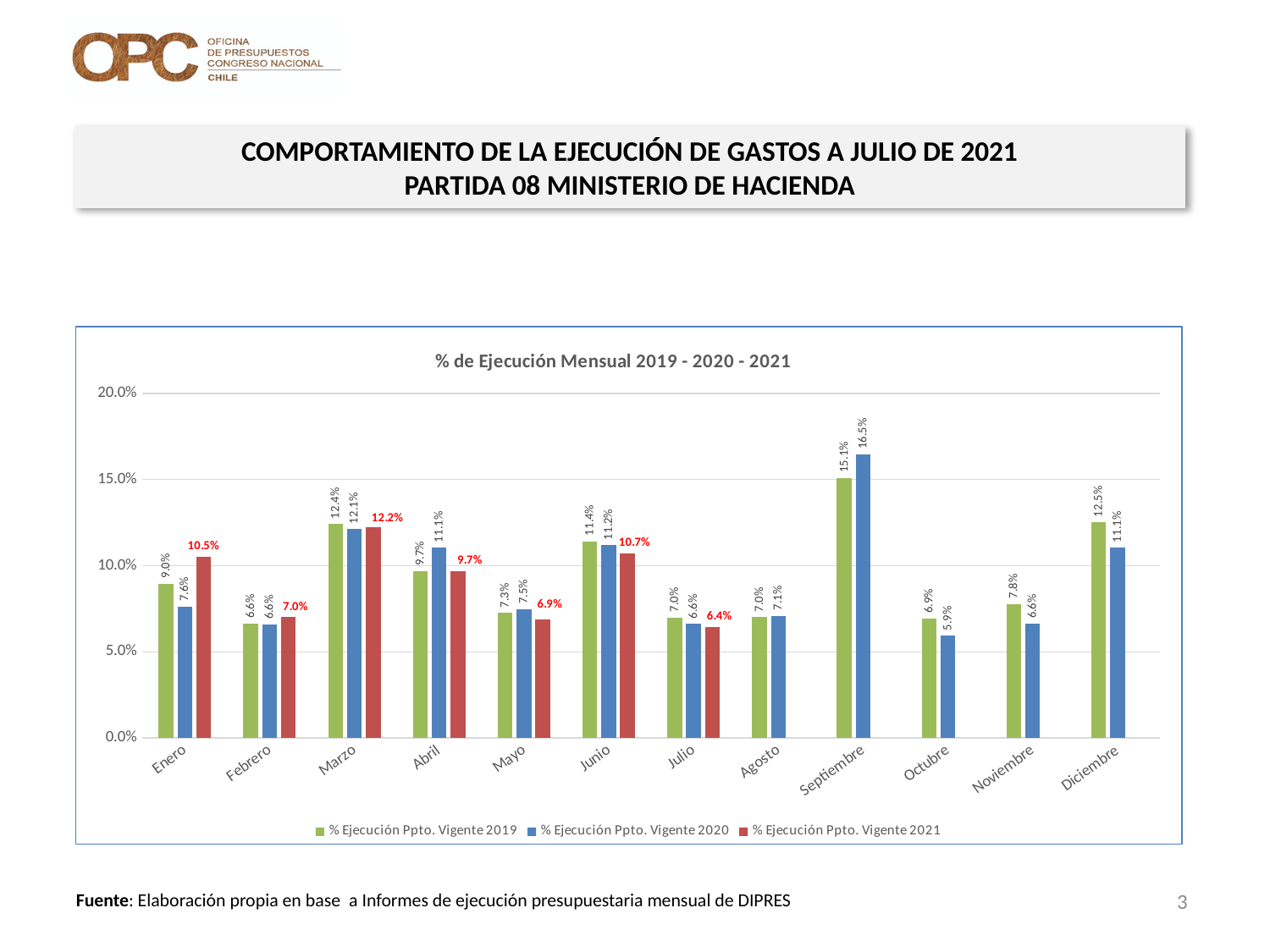
What is the difference between the 2021 and 2020 values for Enero? 2.9% For Abril, which series has the larger value: % Ejecución Ppto. Vigente 2019 or % Ejecución Ppto. Vigente 2020? % Ejecución Ppto. Vigente 2020 Which month has the lowest value for % Ejecución Ppto. Vigente 2020? Octubre What is the difference between the 2020 and 2019 values for Septiembre? 1.4% How many months are shown on the x axis of the chart? 12 What is the value of % Ejecución Ppto. Vigente 2021 for Julio? 6.4% How many series does the legend list? 3 What type of chart is shown on the slide? Bar chart What is the value of % Ejecución Ppto. Vigente 2020 for Septiembre? 16.5% Which month has the highest value for % Ejecución Ppto. Vigente 2019? Septiembre Which month has the highest value for % Ejecución Ppto. Vigente 2021? Marzo What is the value of % Ejecución Ppto. Vigente 2021 for Enero? 10.5%